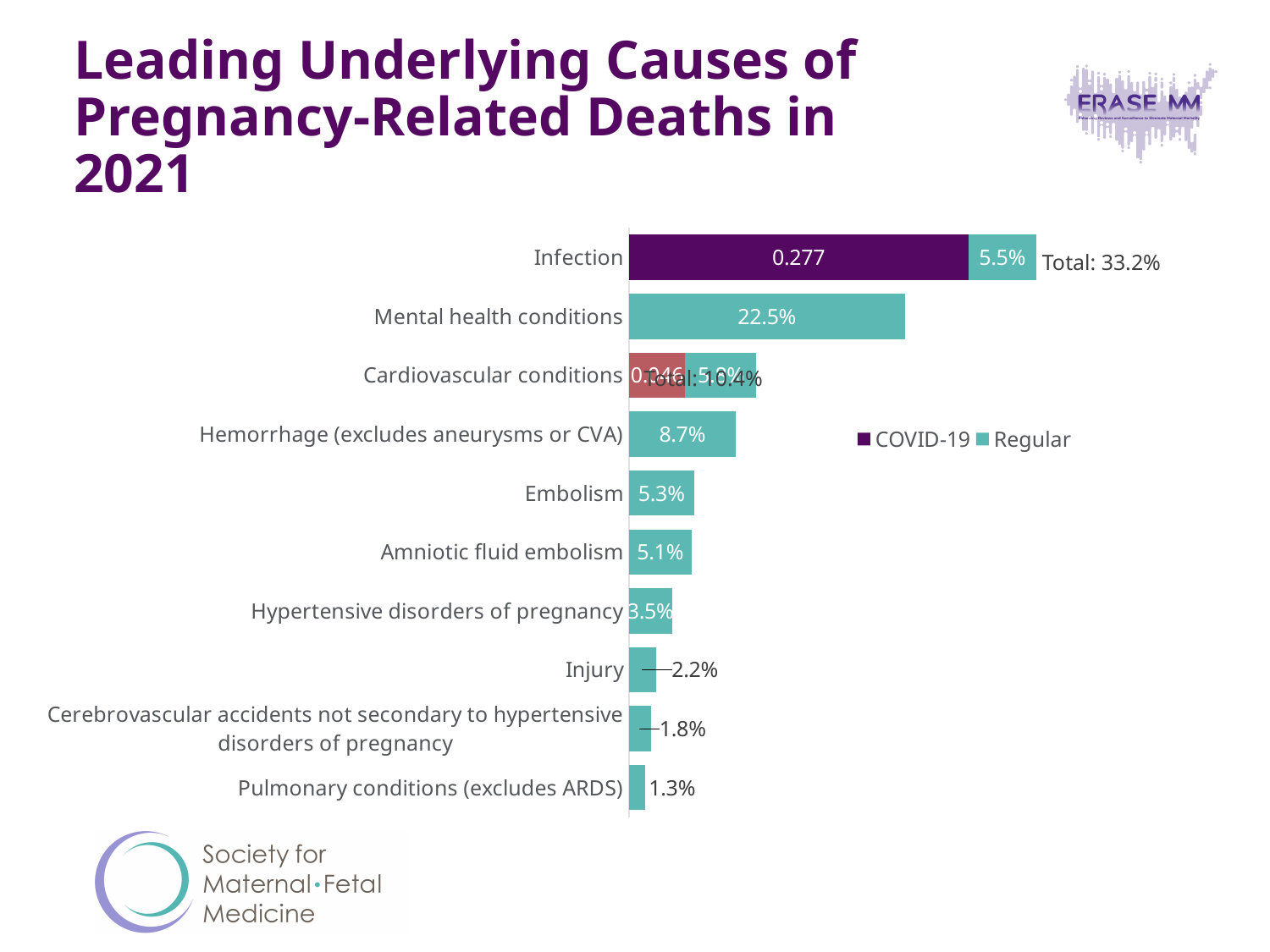
What is the value shown for Hemorrhage (excludes aneurysms or CVA)? 8.7% Which cause has the smallest value? Pulmonary conditions (excludes ARDS) Which cause has the longest bar overall? Infection What is the value shown for Pulmonary conditions (excludes ARDS)? 1.3% Which is larger, the value for Injury or the value for Cerebrovascular accidents not secondary to hypertensive disorders of pregnancy? Injury What kind of chart is shown on the slide? Bar chart What total is shown next to the Infection bar? 33.2% How many series does the legend list? 2 How many causes are listed on the chart? 10 What is the difference between the values for Embolism and Amniotic fluid embolism? 0.2 percentage points What is the value shown for Mental health conditions? 22.5% What is the Regular value shown on the Infection bar? 5.5%